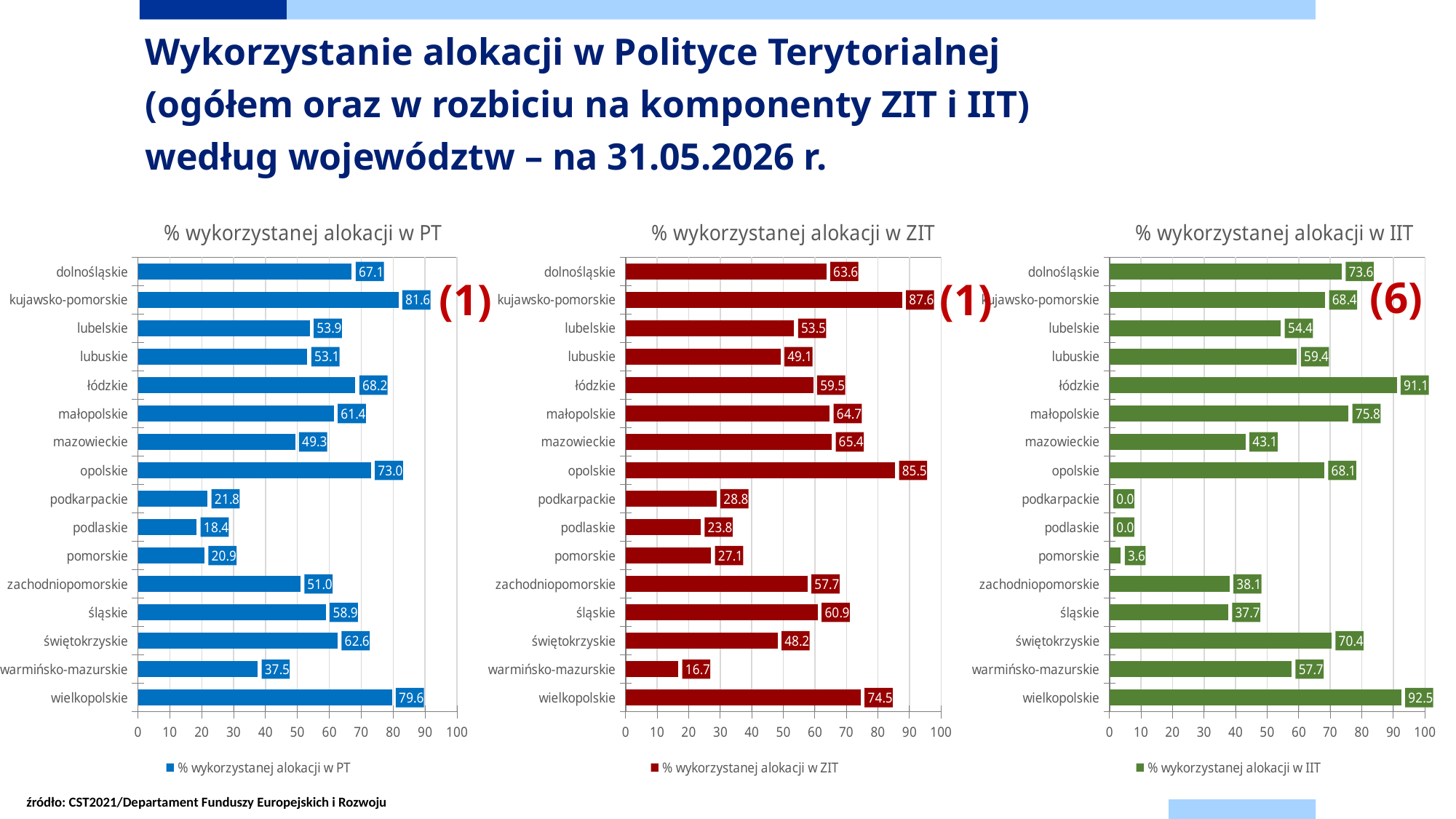
What colour are the bars in the chart titled '% wykorzystanej alokacji w IIT'? green What type of chart is the chart titled '% wykorzystanej alokacji w ZIT'? bar chart In the chart titled '% wykorzystanej alokacji w PT', what is the value for opolskie? 73.0 In the chart titled '% wykorzystanej alokacji w ZIT', which voivodeship has the lowest value? warmińsko-mazurskie In the chart titled '% wykorzystanej alokacji w ZIT', what is the difference between the values for opolskie and wielkopolskie? 11.0 In the chart titled '% wykorzystanej alokacji w IIT', what is the value for świętokrzyskie? 70.4 In the chart titled '% wykorzystanej alokacji w PT', which is larger: the value for lubelskie or the value for lubuskie? lubelskie In the chart titled '% wykorzystanej alokacji w IIT', which voivodeship has the highest value? wielkopolskie In the chart titled '% wykorzystanej alokacji w ZIT', what is the value for mazowieckie? 65.4 How many voivodeships are listed in the chart titled '% wykorzystanej alokacji w PT'? 16 In the chart titled '% wykorzystanej alokacji w PT', which voivodeship has the highest value? kujawsko-pomorskie In the chart titled '% wykorzystanej alokacji w IIT', how many voivodeships have a value of 0.0? 2